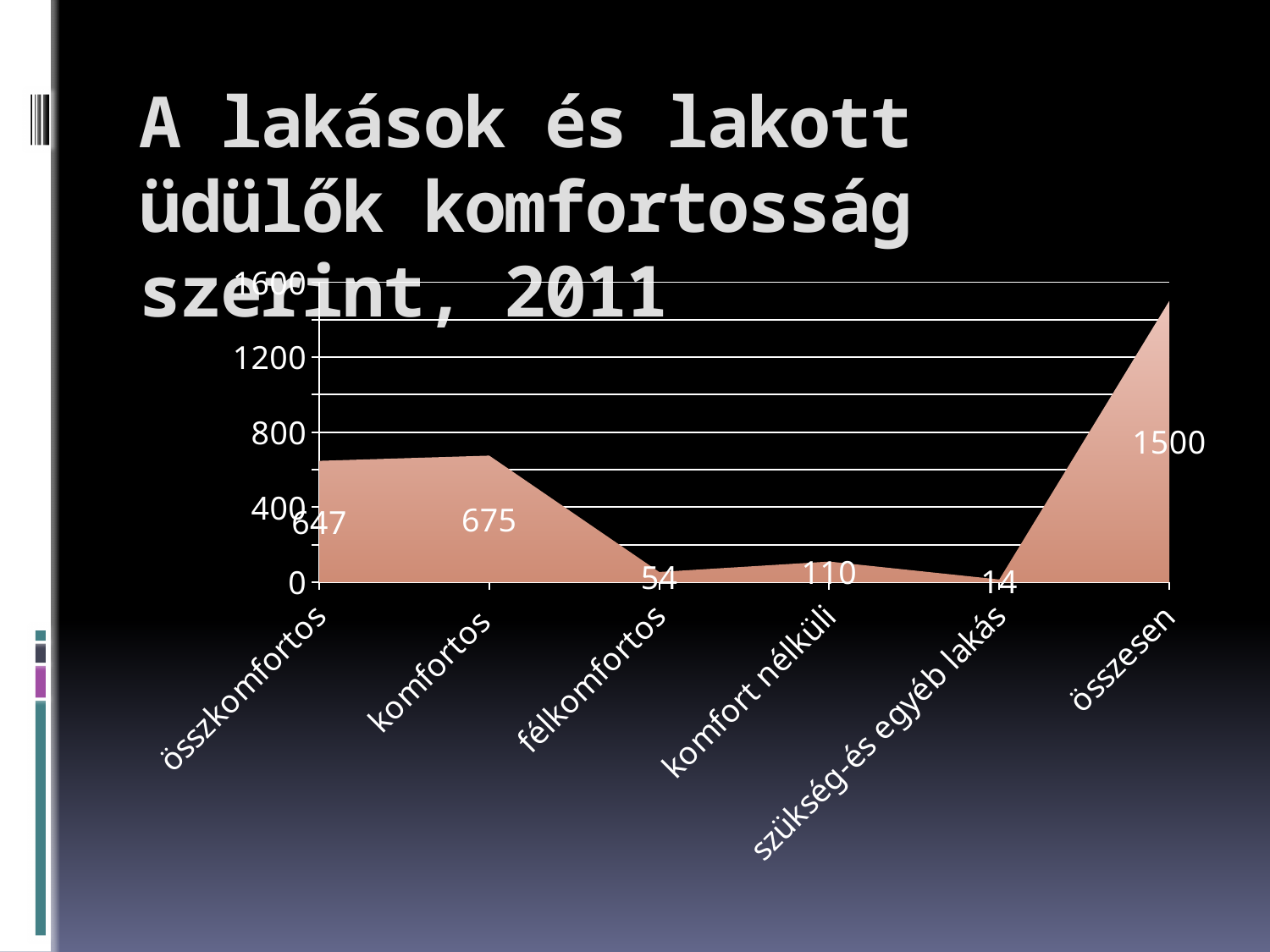
What is the value for komfortos? 675 What is the difference between the values for komfortos and összkomfortos? 28 What is the title of the slide? A lakások és lakott üdülők komfortosság szerint, 2011 What kind of chart is shown on the slide? area chart What is the value for összesen? 1500 How many categories are shown on the x axis? 6 Which category has the lowest value? szükség-és egyéb lakás Which is larger, the value for komfort nélküli or the value for félkomfortos? komfort nélküli Is the value for összkomfortos greater or less than 400? greater What is the value for szükség-és egyéb lakás? 14 What is the value for félkomfortos? 54 Which category has the highest value? összesen